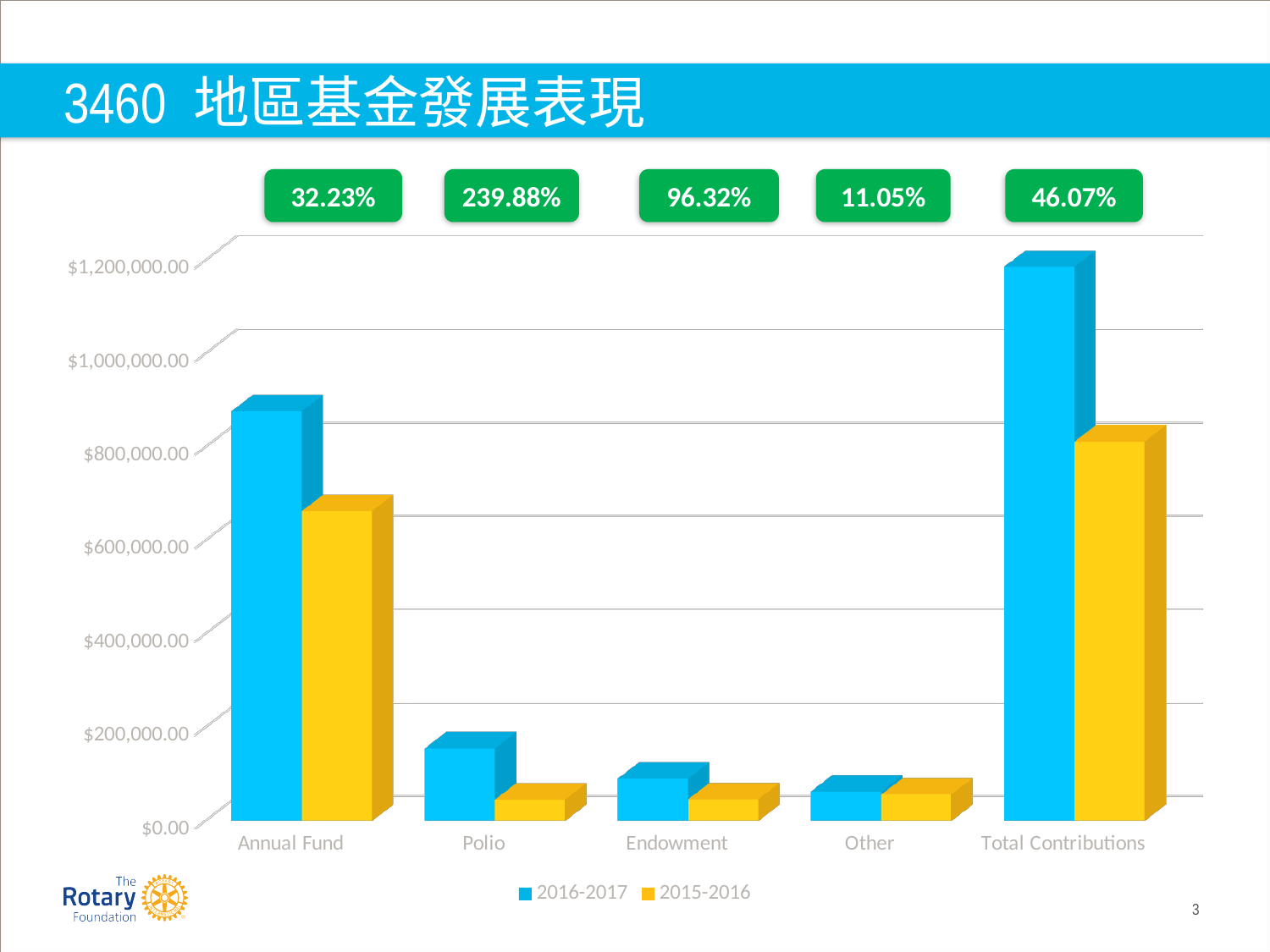
Is the 2016-2017 value for Polio greater or less than $200,000.00? less Which colour represents the 2015-2016 series in the legend? yellow Which category has the lowest 2016-2017 value? Other Is the 2016-2017 value for Annual Fund greater or less than $800,000.00? greater Which category has the highest 2015-2016 value? Total Contributions For Annual Fund, which series has the larger value, 2016-2017 or 2015-2016? 2016-2017 What kind of chart is shown on the slide? bar chart Which category has the highest 2016-2017 value? Total Contributions Is the 2016-2017 value for Total Contributions greater or less than $1,000,000.00? greater How many categories are shown on the x axis of the chart? 5 What percentage is shown in the green box above the Polio category? 239.88% How many series does the chart legend list? 2